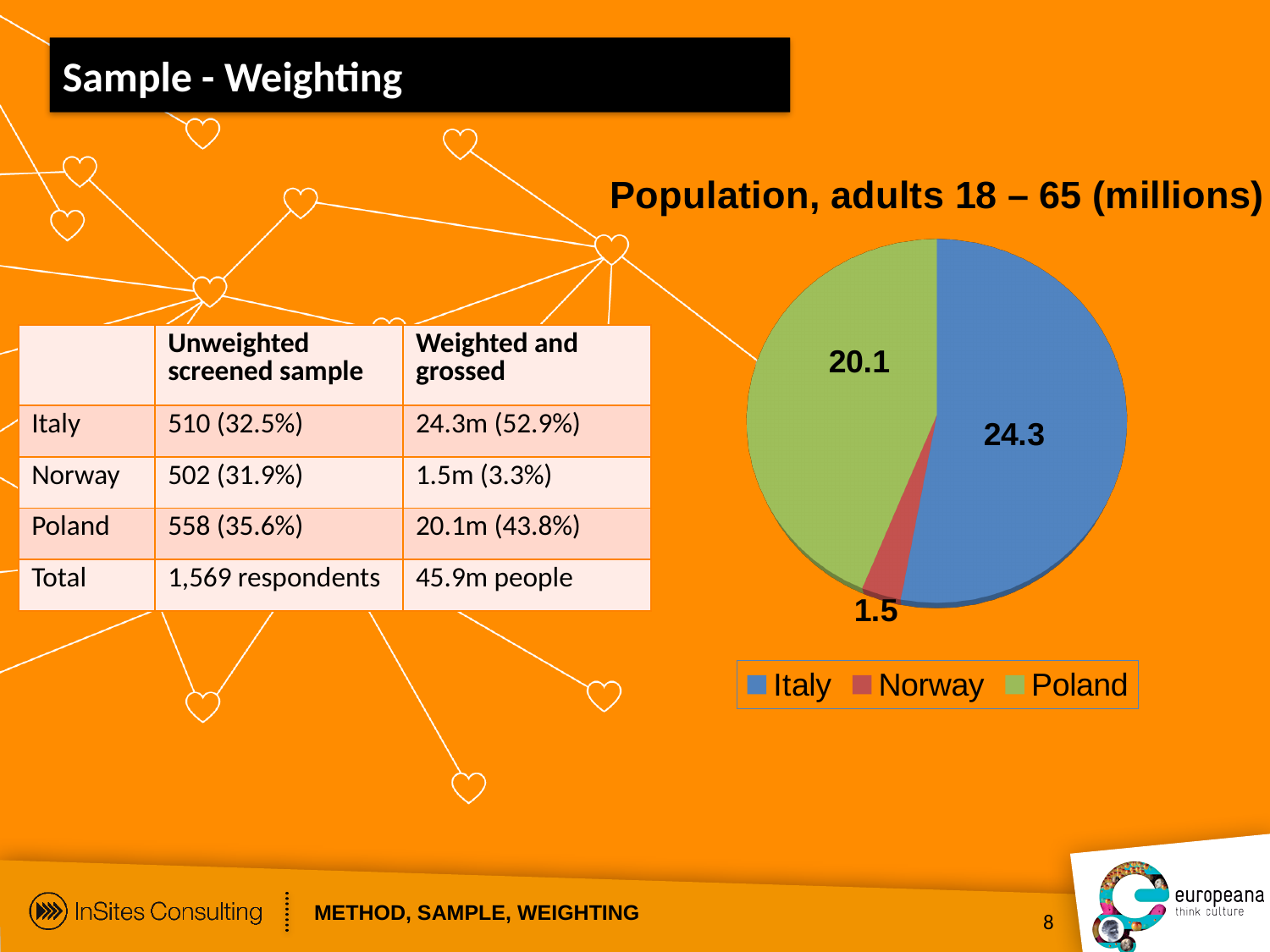
What share of the pie does Italy represent? 52.9% What is the value shown for Norway in the pie chart? 1.5 What is the value shown for Poland in the pie chart? 20.1 What is the value shown for Italy in the pie chart? 24.3 What type of chart is shown on the slide? pie chart What is the difference between the values for Italy and Poland in the pie chart? 4.2 Which country has the smallest slice in the pie chart? Norway What is the title of the pie chart? Population, adults 18 – 65 (millions) Which country has the largest slice in the pie chart? Italy Which is larger in the pie chart, the value for Poland or the value for Norway? Poland How many slices does the pie chart have? 3 How many entries does the legend of the pie chart list? 3